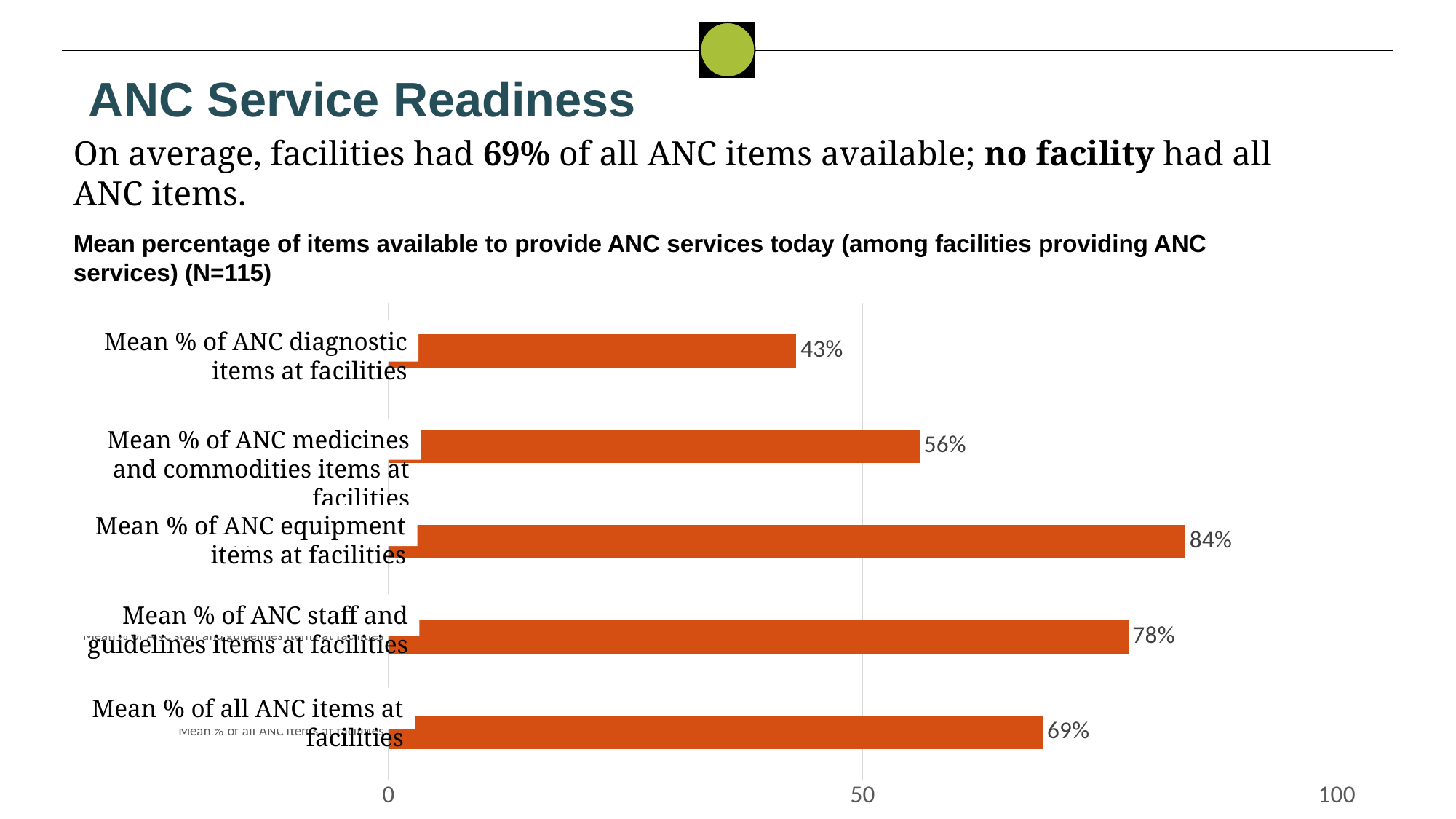
What is the mean % of ANC staff and guidelines items at facilities? 78% What is the mean % of all ANC items at facilities? 69% What is the difference between the mean % of ANC equipment items and the mean % of ANC diagnostic items? 41% What is the mean % of ANC medicines and commodities items at facilities? 56% What is the mean % of ANC diagnostic items at facilities? 43% Which category has the highest mean percentage of items available? Mean % of ANC equipment items at facilities Which category has the lowest mean percentage of items available? Mean % of ANC diagnostic items at facilities Is the mean % of ANC diagnostic items at facilities greater or less than 50? less Which is larger: the mean % of ANC staff and guidelines items or the mean % of ANC medicines and commodities items? Mean % of ANC staff and guidelines items at facilities What is the mean % of ANC equipment items at facilities? 84% What type of chart is shown on the slide? Bar chart How many categories are shown in the chart? 5